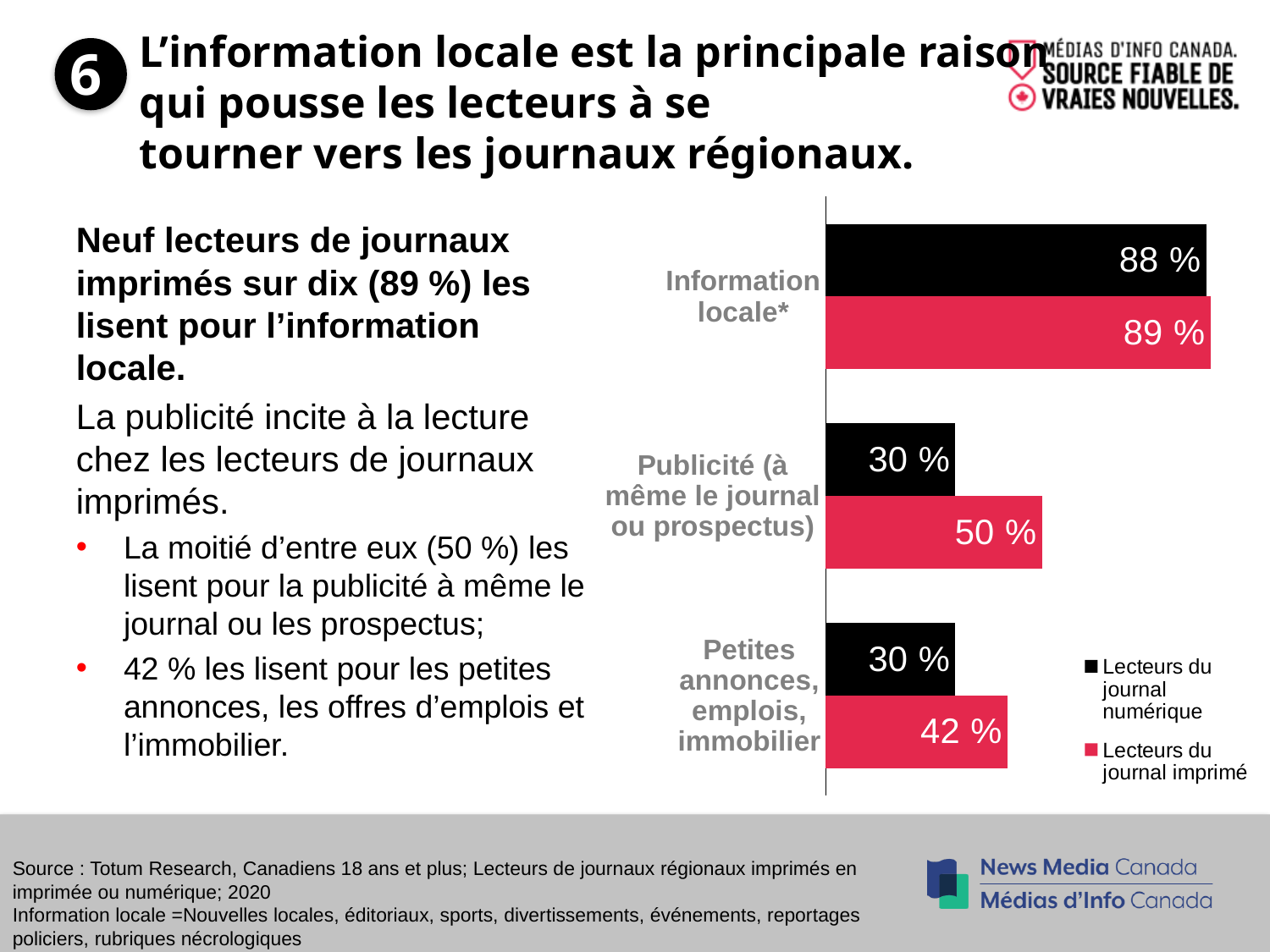
How many series does the legend list? 2 What kind of chart is shown on the slide? Bar chart What is the difference between Lecteurs du journal imprimé and Lecteurs du journal numérique for Petites annonces, emplois, immobilier? 12 % What is the value for Petites annonces, emplois, immobilier among Lecteurs du journal numérique? 30 % For Publicité (à même le journal ou prospectus), which series has the larger value: Lecteurs du journal numérique or Lecteurs du journal imprimé? Lecteurs du journal imprimé What is the value for Information locale* among Lecteurs du journal imprimé? 89 % How many categories are shown in the chart? 3 Which category has the lowest value for Lecteurs du journal imprimé? Petites annonces, emplois, immobilier What is the value for Publicité (à même le journal ou prospectus) among Lecteurs du journal imprimé? 50 % Which category has the highest value for Lecteurs du journal imprimé? Information locale* What is the difference between Lecteurs du journal imprimé and Lecteurs du journal numérique for Publicité (à même le journal ou prospectus)? 20 % What is the value for Information locale* among Lecteurs du journal numérique? 88 %